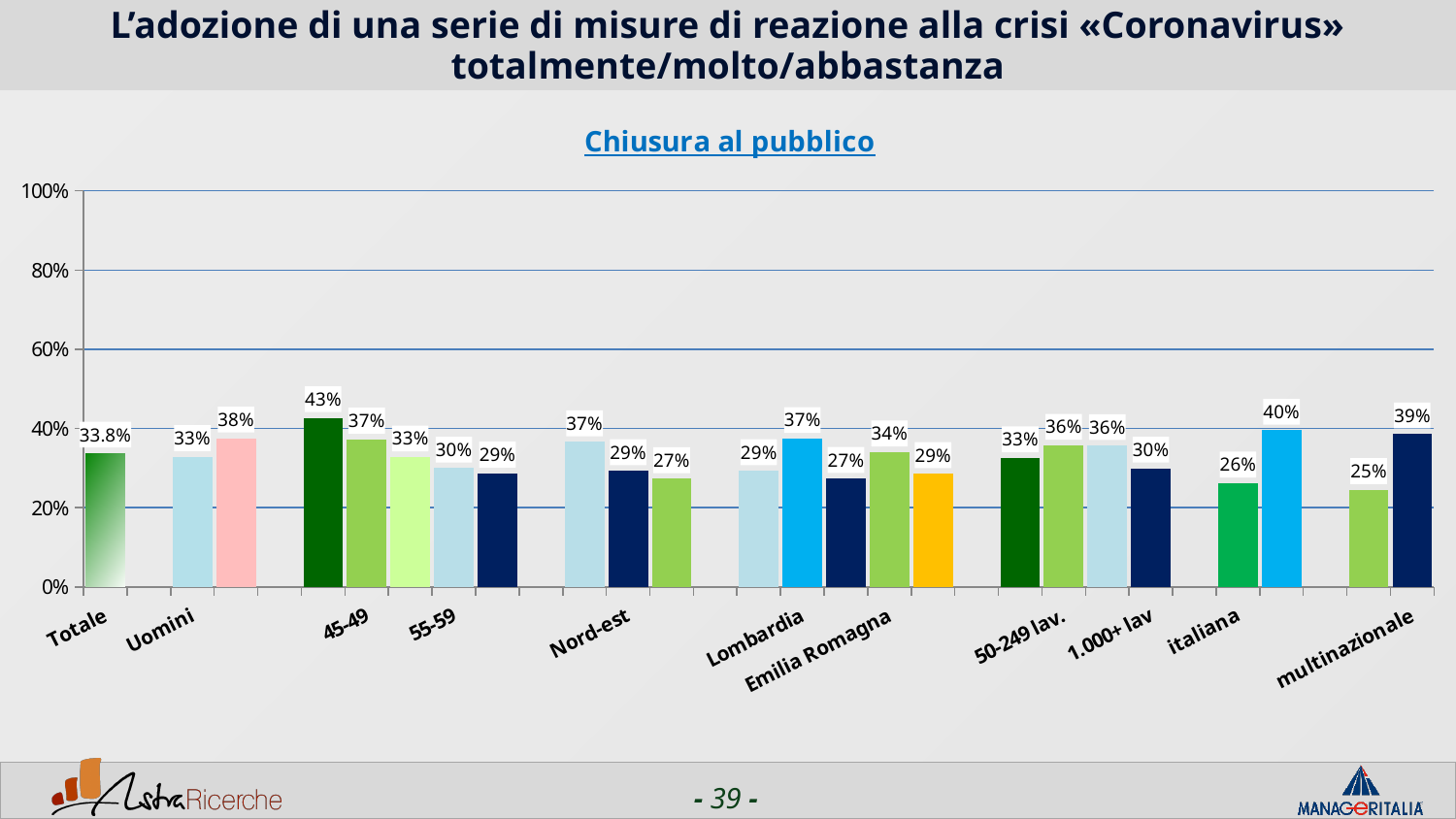
What is the value for Emilia Romagna? 34% What is the value for italiana? 26% What is the title of the chart? Chiusura al pubblico What is the highest value labelled on any bar in the chart? 43% Is the value for Totale greater or less than 40%? less What is the difference between the value for multinazionale and the value for italiana? 13 percentage points What is the value for Uomini? 33% What is the value for Lombardia? 37% Which is larger, the value for multinazionale or the value for italiana? multinazionale What is the value for multinazionale? 39% What is the value for Totale? 33.8% What type of chart is shown on the slide? bar chart